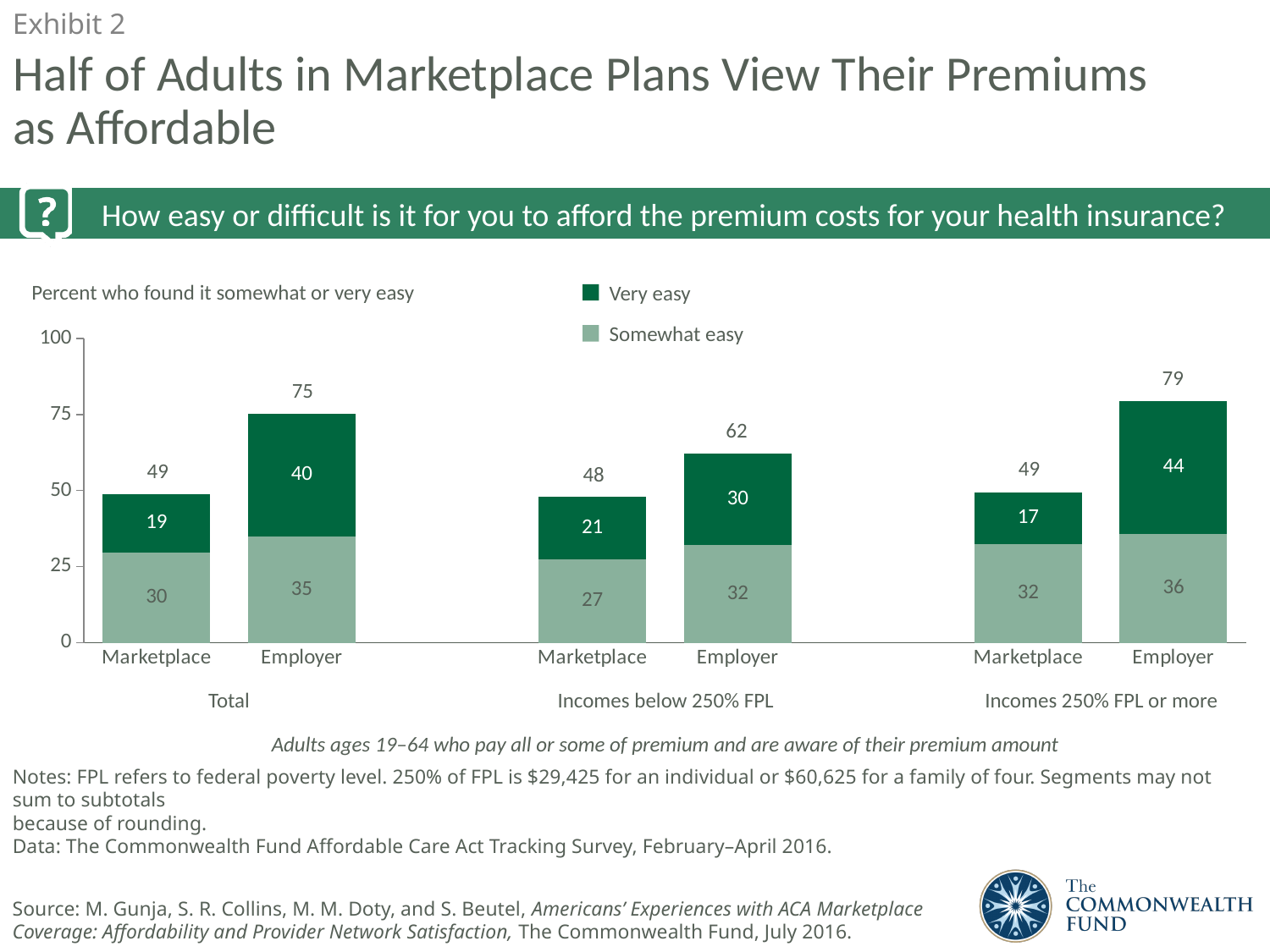
What percent of adults in Marketplace plans in the Total group found it very easy to afford their premium? 19 Is the total for Marketplace plans among adults with incomes 250% FPL or more greater or less than 50? less Which legend entry is shown in dark green? Very easy Which bar has the lowest total percent who found it somewhat or very easy? Marketplace, Incomes below 250% FPL What is the difference between the Employer and Marketplace totals in the Total group? 26 What is the 'Somewhat easy' value for Employer plans among adults with incomes below 250% FPL? 32 Which bar has the highest total percent who found it somewhat or very easy? Employer, Incomes 250% FPL or more How many series does the legend list? 2 What is the total percent who found it somewhat or very easy for Employer plans among adults with incomes 250% FPL or more? 79 What kind of chart is shown on the slide? Stacked bar chart Which is larger: the 'Very easy' value for Employer plans in the Total group or the 'Very easy' value for Employer plans among incomes below 250% FPL? Employer plans in the Total group How many bars are plotted in the chart? 6